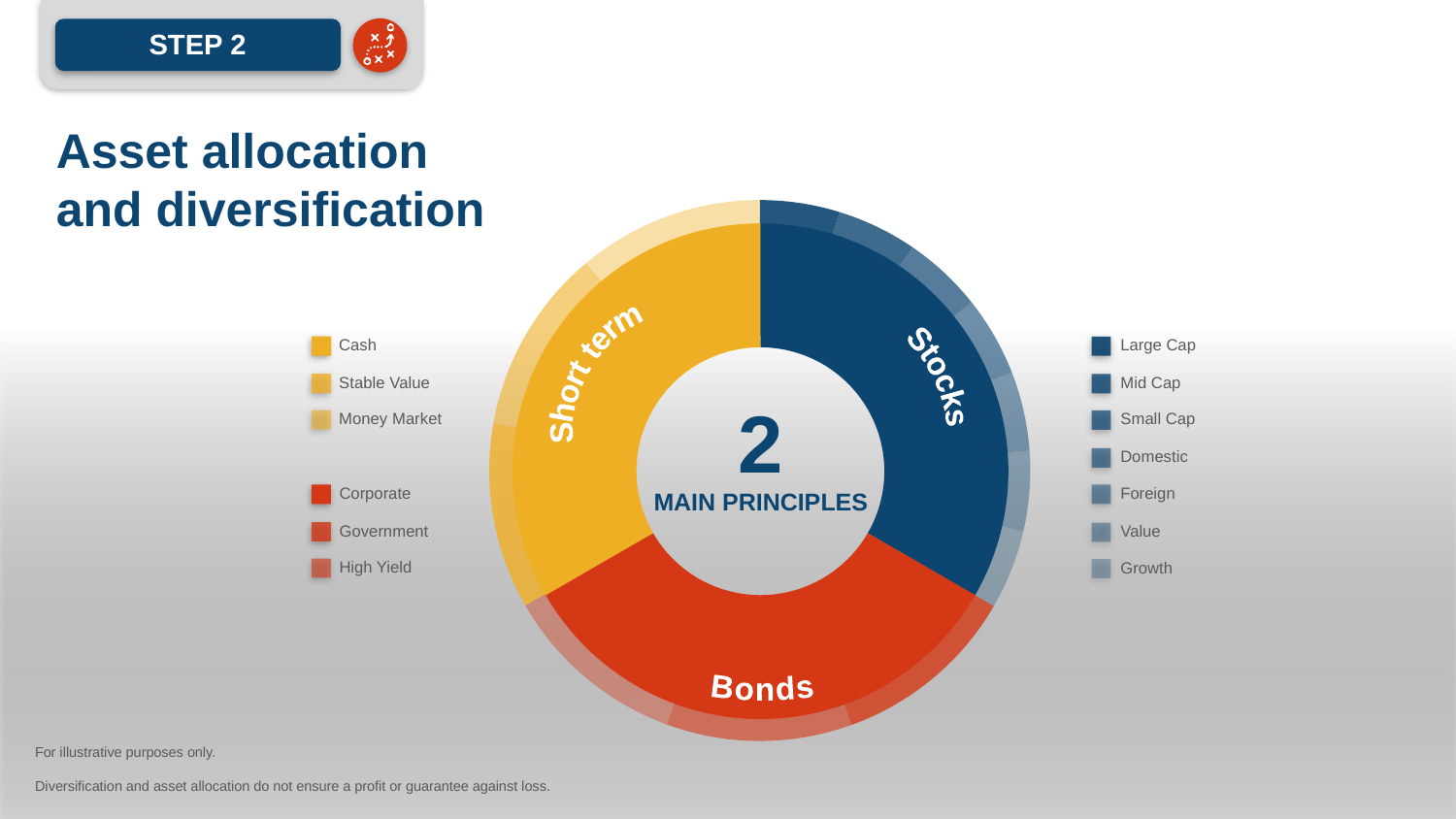
How many sub-categories are listed in the legend for the Stocks segment? 7 Which segment of the donut chart is colored dark blue? Stocks What are the three segments of the donut chart labeled? Short term, Stocks, Bonds How many sub-categories are listed in the legend for the Bonds segment? 3 Which segment of the donut chart is colored yellow? Short term Which segment of the donut chart is colored red? Bonds How many main segments does the donut chart have? 3 What text appears in the center of the donut chart? 2 MAIN PRINCIPLES What kind of chart is shown on the slide? Pie (donut) chart